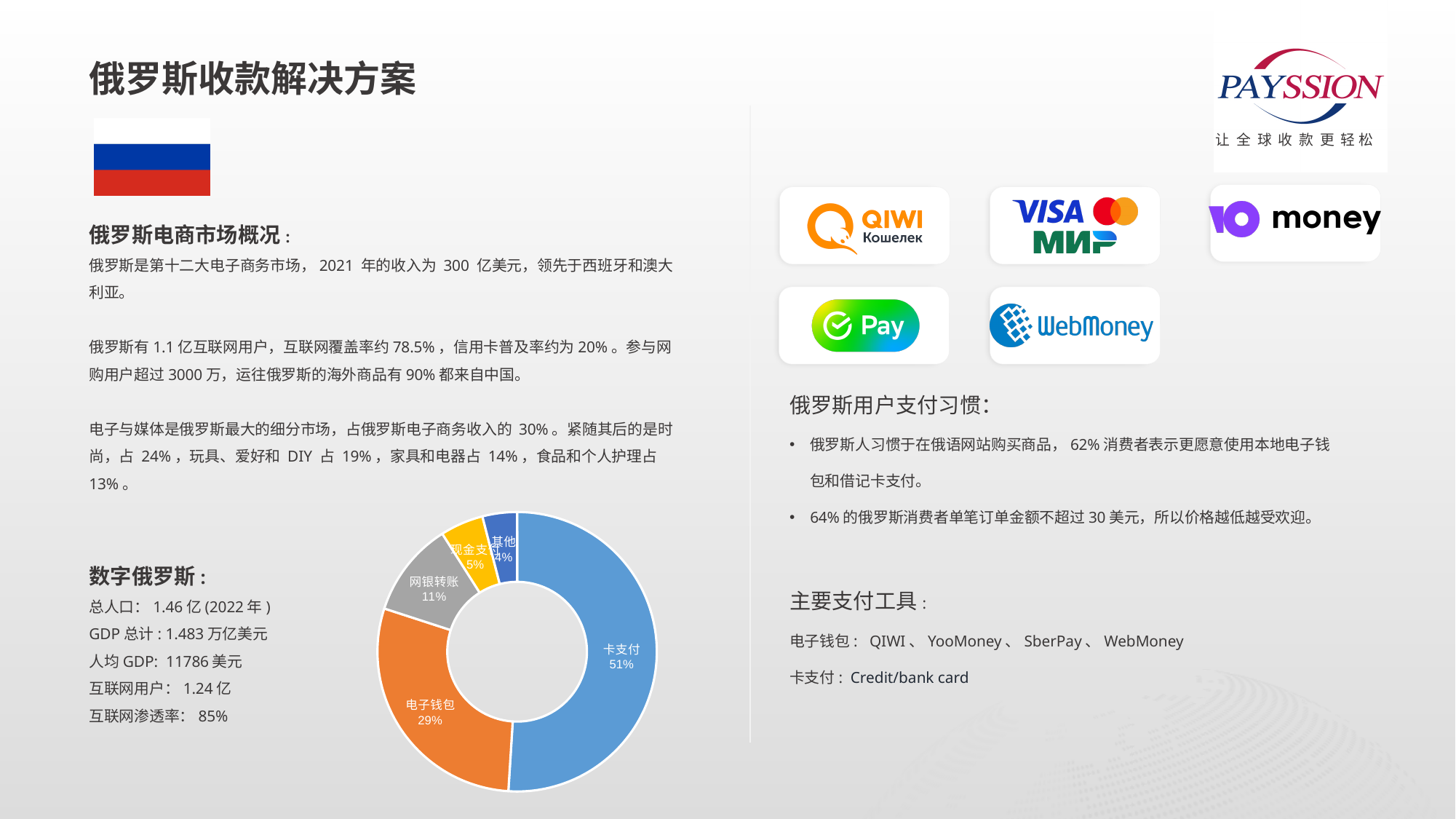
What is the value shown for 电子钱包 in the doughnut chart? 29% What is the difference in percentage points between 卡支付 and 电子钱包 in the doughnut chart? 22 Which category has the largest slice in the doughnut chart? 卡支付 What percentage does 网银转账 represent in the doughnut chart? 11% Which category has the smallest slice in the doughnut chart? 其他 What colour is the 卡支付 slice in the doughnut chart? Blue What is the value labelled for 现金支付 in the doughnut chart? 5% What is the combined share of 电子钱包 and 网银转账 in the doughnut chart? 40% Which is larger in the doughnut chart, 网银转账 or 现金支付? 网银转账 How many categories are shown in the doughnut chart? 5 What type of chart is shown on the slide? Doughnut chart What share of the doughnut chart does 卡支付 account for? 51%